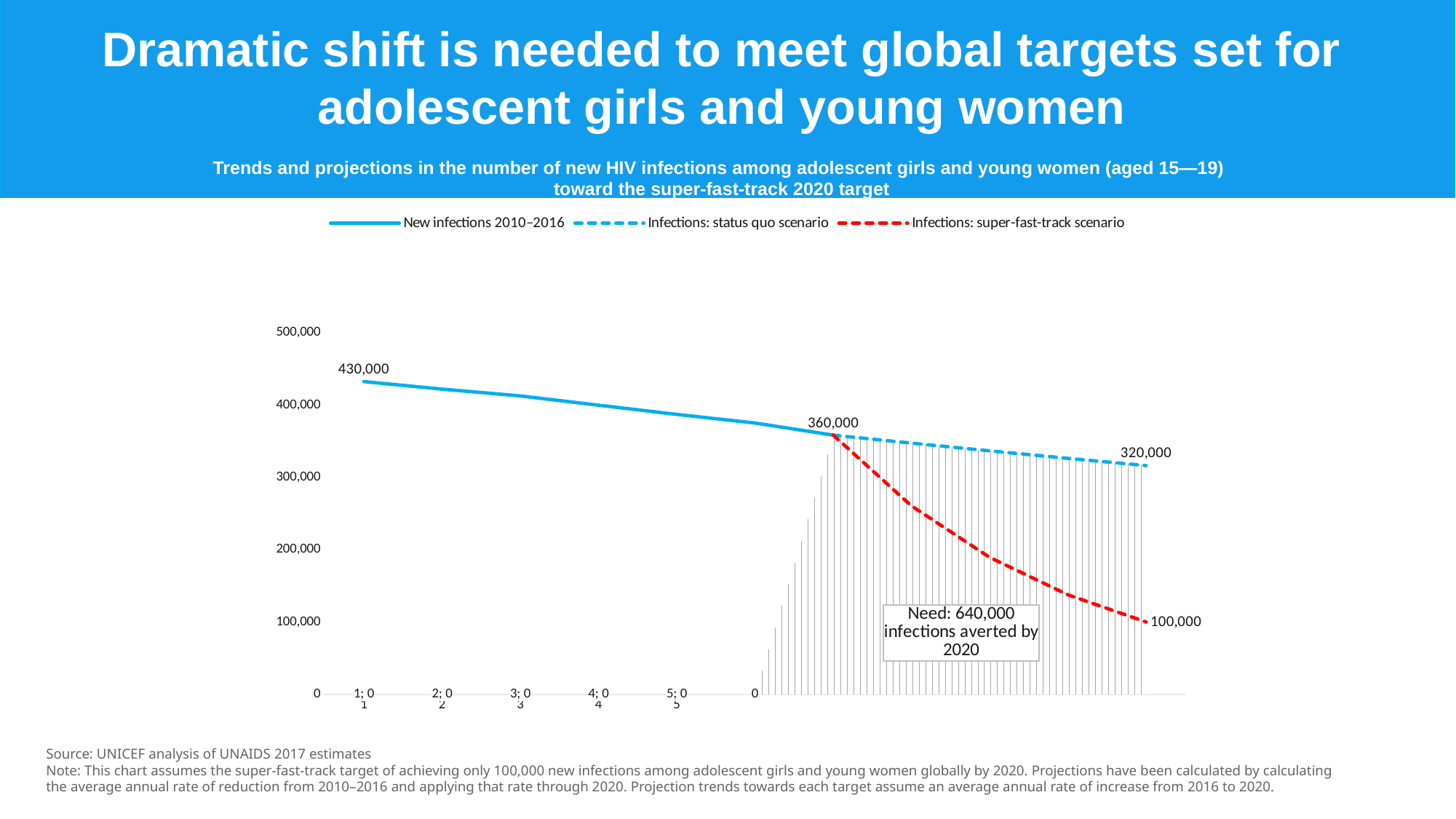
What is the final labelled value of the Infections: super-fast-track scenario line? 100,000 What is the difference between the final status quo scenario value and the final super-fast-track scenario value? 220,000 By how much does the New infections 2010–2016 line fall from its first labelled value to its last labelled value? 70,000 What is the starting value of the New infections 2010–2016 line? 430,000 Does the New infections 2010–2016 line rise or fall along the x axis? fall What is the final labelled value of the Infections: status quo scenario line? 320,000 According to the annotation box on the chart, how many infections need to be averted by 2020? 640,000 What colour is the Infections: super-fast-track scenario line? red How many series does the legend list? 3 What type of chart is shown on the slide? line chart What value is labelled at the point where the solid line ends and the dashed projections begin? 360,000 Which ends higher, the status quo scenario line or the super-fast-track scenario line? status quo scenario